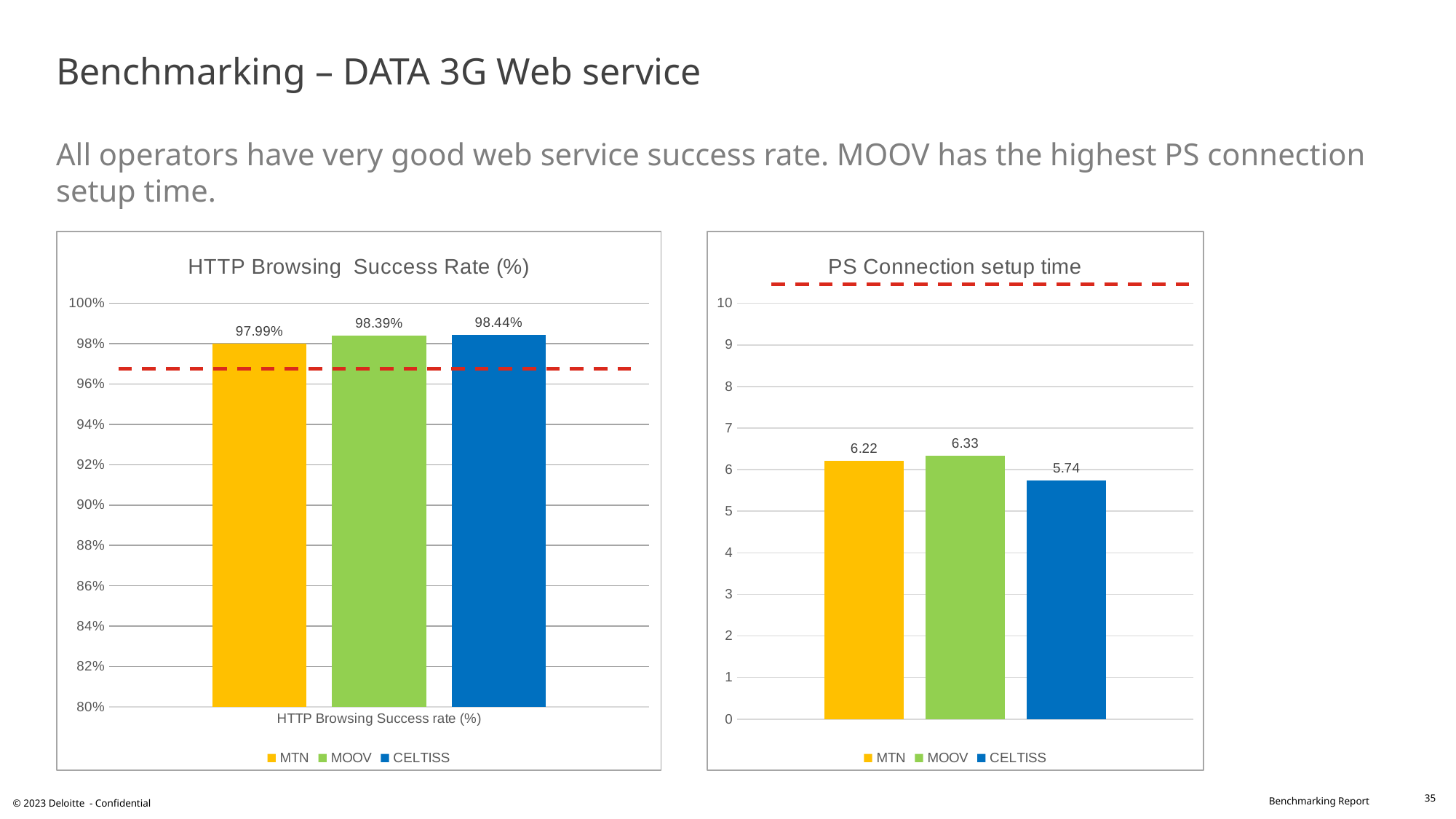
In the PS Connection setup time chart, is the value for MTN greater or less than 6? greater In the HTTP Browsing Success Rate (%) chart, what is the value for MTN? 97.99% In the PS Connection setup time chart, what is the difference between the MOOV and CELTISS values? 0.59 In the HTTP Browsing Success Rate (%) chart, which operator has the lowest success rate? MTN What kind of chart is the HTTP Browsing Success Rate (%) chart? Bar chart In the PS Connection setup time chart, which operator has the lowest setup time? CELTISS In the PS Connection setup time chart, what is the value for CELTISS? 5.74 In the PS Connection setup time chart, what is the value for MOOV? 6.33 How many series does the legend of the PS Connection setup time chart list? 3 In the HTTP Browsing Success Rate (%) chart, what is the value for CELTISS? 98.44% In the HTTP Browsing Success Rate (%) chart, what is the difference in percentage points between CELTISS and MTN? 0.45 In the PS Connection setup time chart, which operator has the highest setup time? MOOV